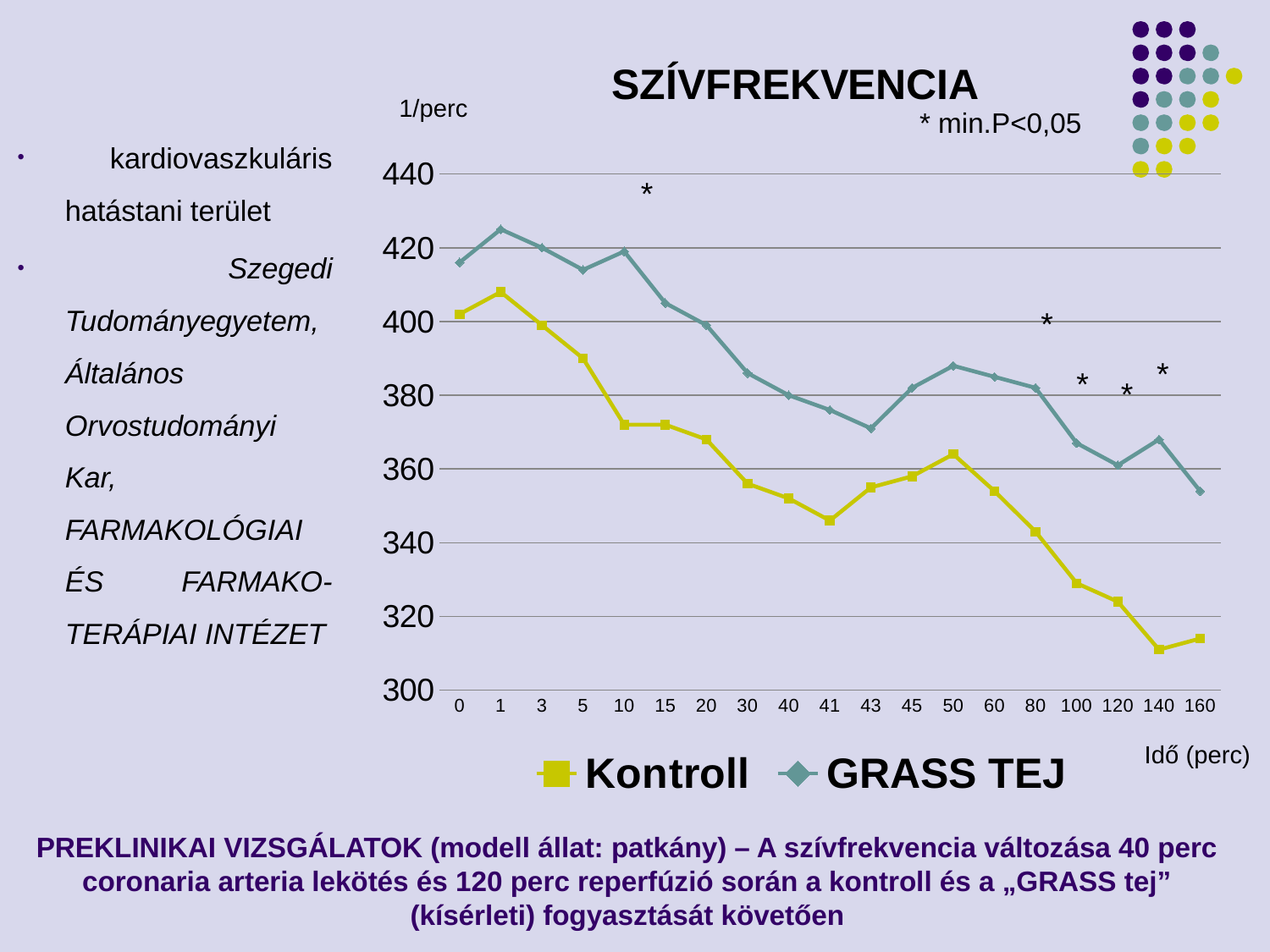
At 160 minutes, which series has the higher value, Kontroll or GRASS TEJ? GRASS TEJ What is the title of the chart? SZÍVFREKVENCIA Is the Kontroll value at 100 minutes greater or less than 340? less What is the label of the x axis? Idő (perc) Is the Kontroll value at 140 minutes greater or less than 320? less Does the Kontroll series generally rise or fall from 0 to 160 minutes? fall Is the GRASS TEJ value at 1 minute greater or less than 420? greater What kind of chart is shown on the slide? line chart How many time points are plotted along the x axis? 19 How many series does the legend list? 2